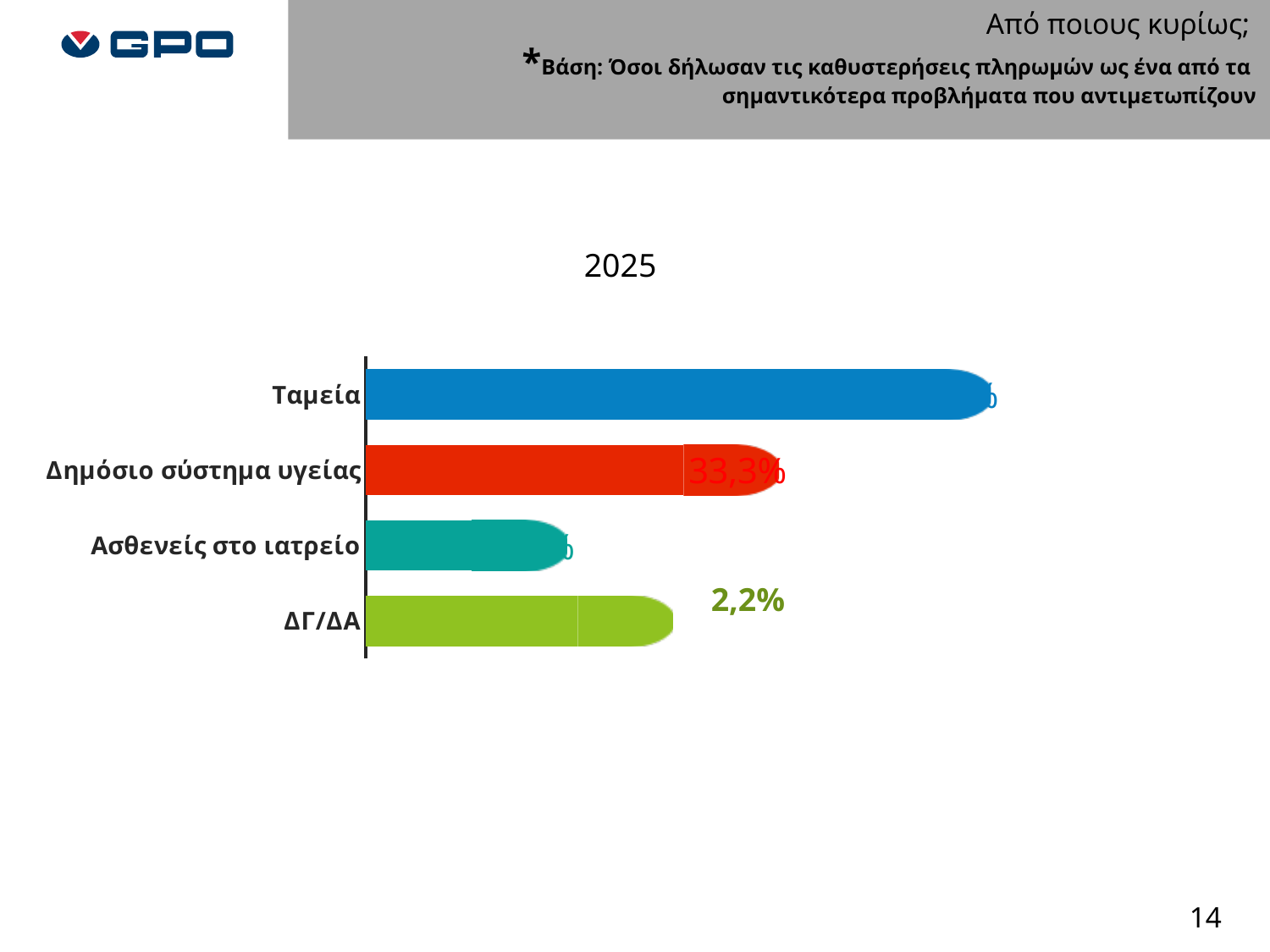
What is the value shown for ΔΓ/ΔΑ? 2,2% Which category has the longest bar in the chart? Ταμεία Which is larger, the value for Δημόσιο σύστημα υγείας or the value for ΔΓ/ΔΑ? Δημόσιο σύστημα υγείας How many categories are shown in the chart? 4 Which is larger, the value for Ταμεία or the value for Δημόσιο σύστημα υγείας? Ταμεία What is the title of the chart? 2025 What kind of chart is shown on the slide? Bar chart Which category is listed at the top of the chart? Ταμεία What colour is the bar for Δημόσιο σύστημα υγείας? Red What is the value shown for Δημόσιο σύστημα υγείας? 33,3%